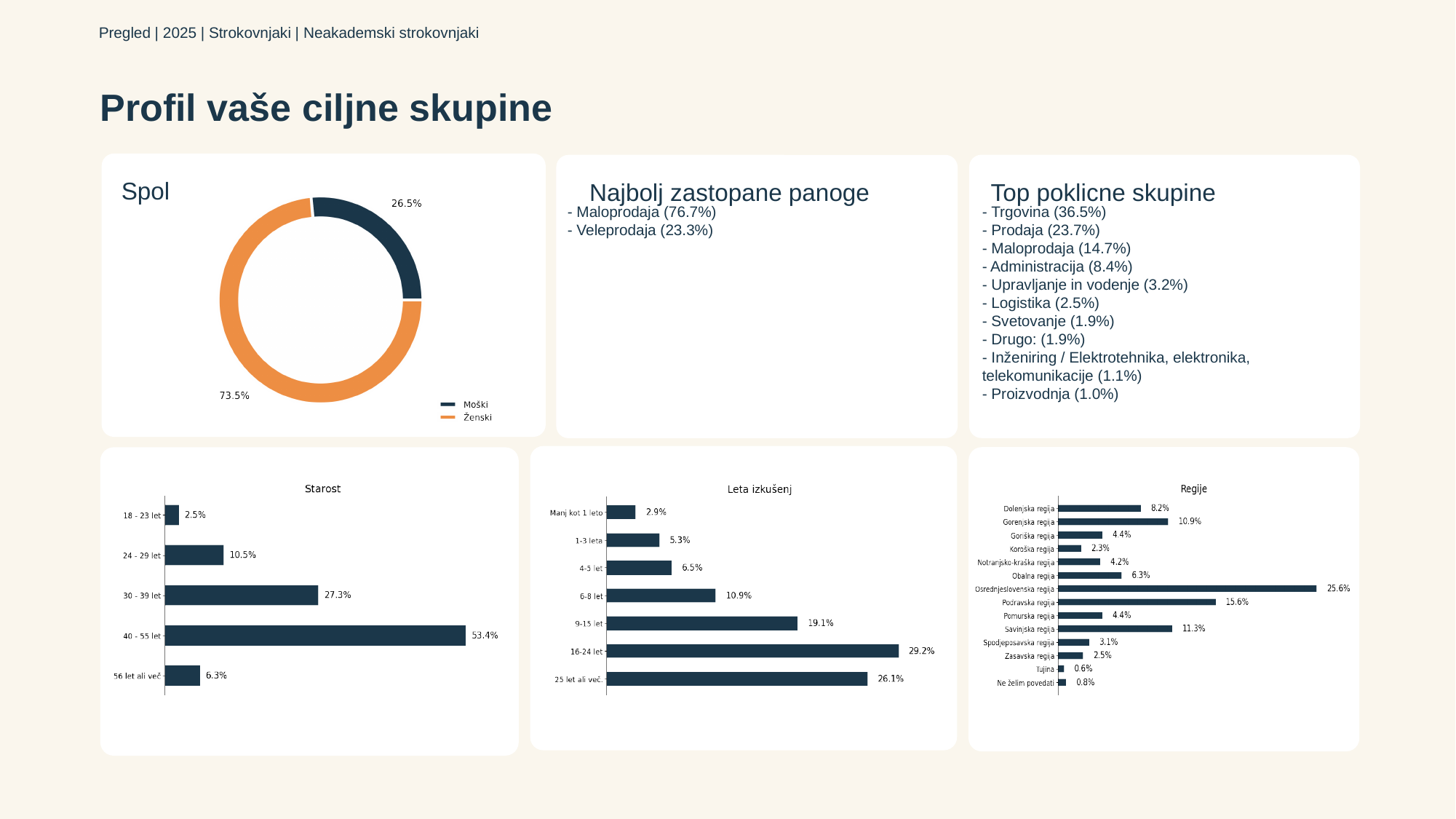
What kind of chart is the Spol chart? Donut (pie) chart In the Starost chart, which age group has the lowest value? 18 - 23 let In the Spol chart, what share is labelled for Ženski? 73.5% In the Starost chart, what is the value for 40 - 55 let? 53.4% In the Starost chart, what is the difference between the values for 30 - 39 let and 24 - 29 let? 16.8% In the Regije chart, what is the value for Tujina? 0.6% In the Regije chart, which region has the highest value? Osrednjeslovenska regija In the Leta izkušenj chart, what is the value for 9-15 let? 19.1% In the Leta izkušenj chart, which category has the highest value? 16-24 let In the Spol chart, what share is labelled for Moški? 26.5% How many categories does the Leta izkušenj chart show? 7 In the Regije chart, which is larger, Podravska regija or Savinjska regija? Podravska regija